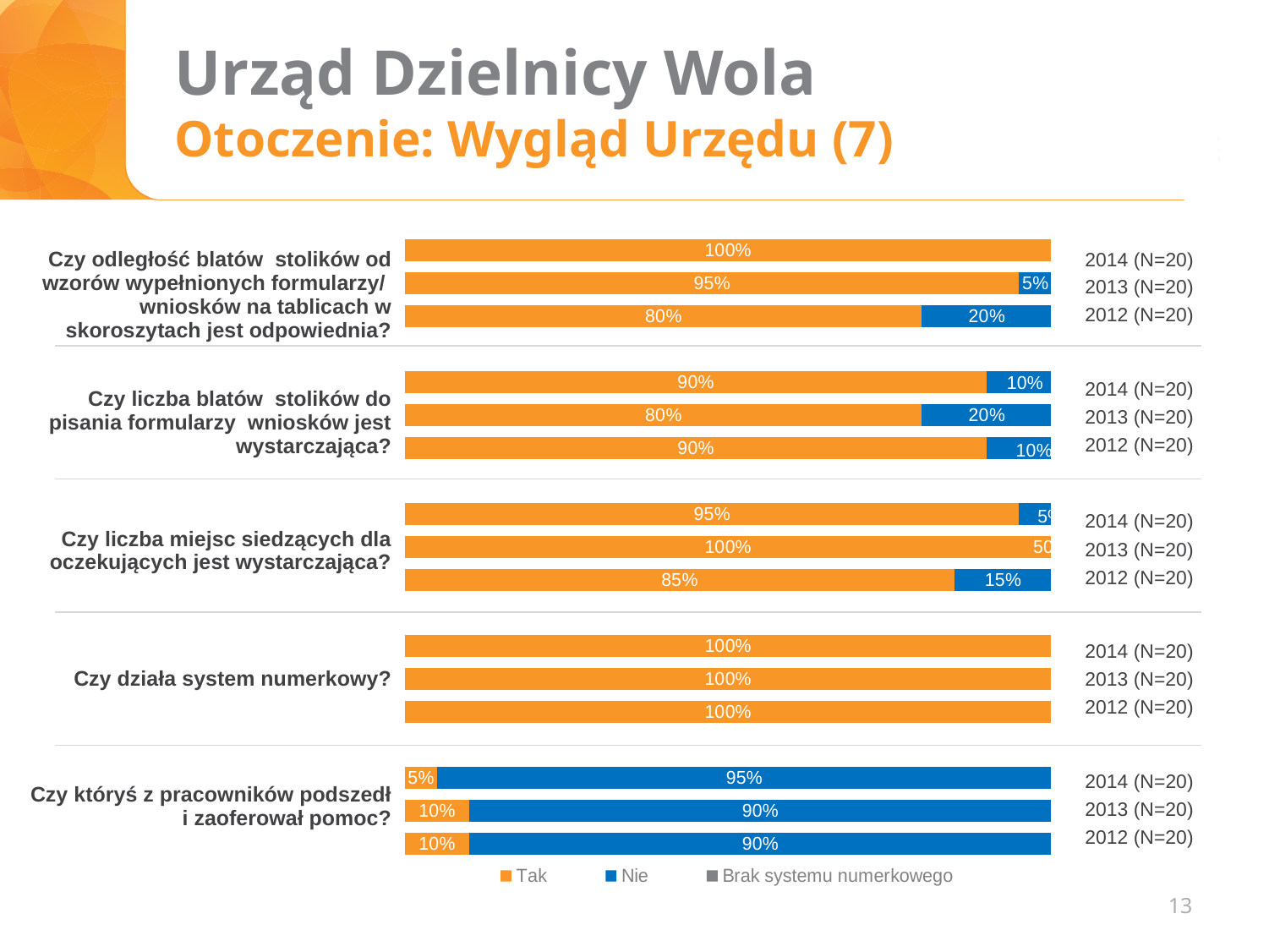
In the chart for "Czy liczba miejsc siedzących dla oczekujących jest wystarczająca?", what is the "Nie" value for 2012 (N=20)? 15% In the chart for "Czy odległość blatów stolików od wzorów wypełnionych formularzy/wniosków na tablicach w skoroszytach jest odpowiednia?", does the "Tak" value rise or fall from 2012 to 2014? rise In the chart for "Czy któryś z pracowników podszedł i zaoferował pomoc?", which is larger for 2013 (N=20): the "Tak" value or the "Nie" value? Nie In the chart for "Czy liczba blatów stolików do pisania formularzy wniosków jest wystarczająca?", which year has the lowest "Tak" value? 2013 (N=20) In the chart for "Czy liczba miejsc siedzących dla oczekujących jest wystarczająca?", what is the difference between the "Tak" values for 2014 (N=20) and 2012 (N=20)? 10% In the chart for "Czy odległość blatów stolików od wzorów wypełnionych formularzy/wniosków na tablicach w skoroszytach jest odpowiednia?", what is the "Tak" value for 2012 (N=20)? 80% In the chart for "Czy działa system numerkowy?", what is the "Tak" value for 2013 (N=20)? 100% What kind of chart is used on this slide? stacked bar chart In the chart for "Czy liczba blatów stolików do pisania formularzy wniosków jest wystarczająca?", what is the "Nie" value for 2013 (N=20)? 20% In the chart for "Czy któryś z pracowników podszedł i zaoferował pomoc?", what is the "Nie" value for 2014 (N=20)? 95% How many series does the legend at the bottom of the slide list? 3 In the chart for "Czy odległość blatów stolików od wzorów wypełnionych formularzy/wniosków na tablicach w skoroszytach jest odpowiednia?", what is the "Nie" value for 2013 (N=20)? 5%